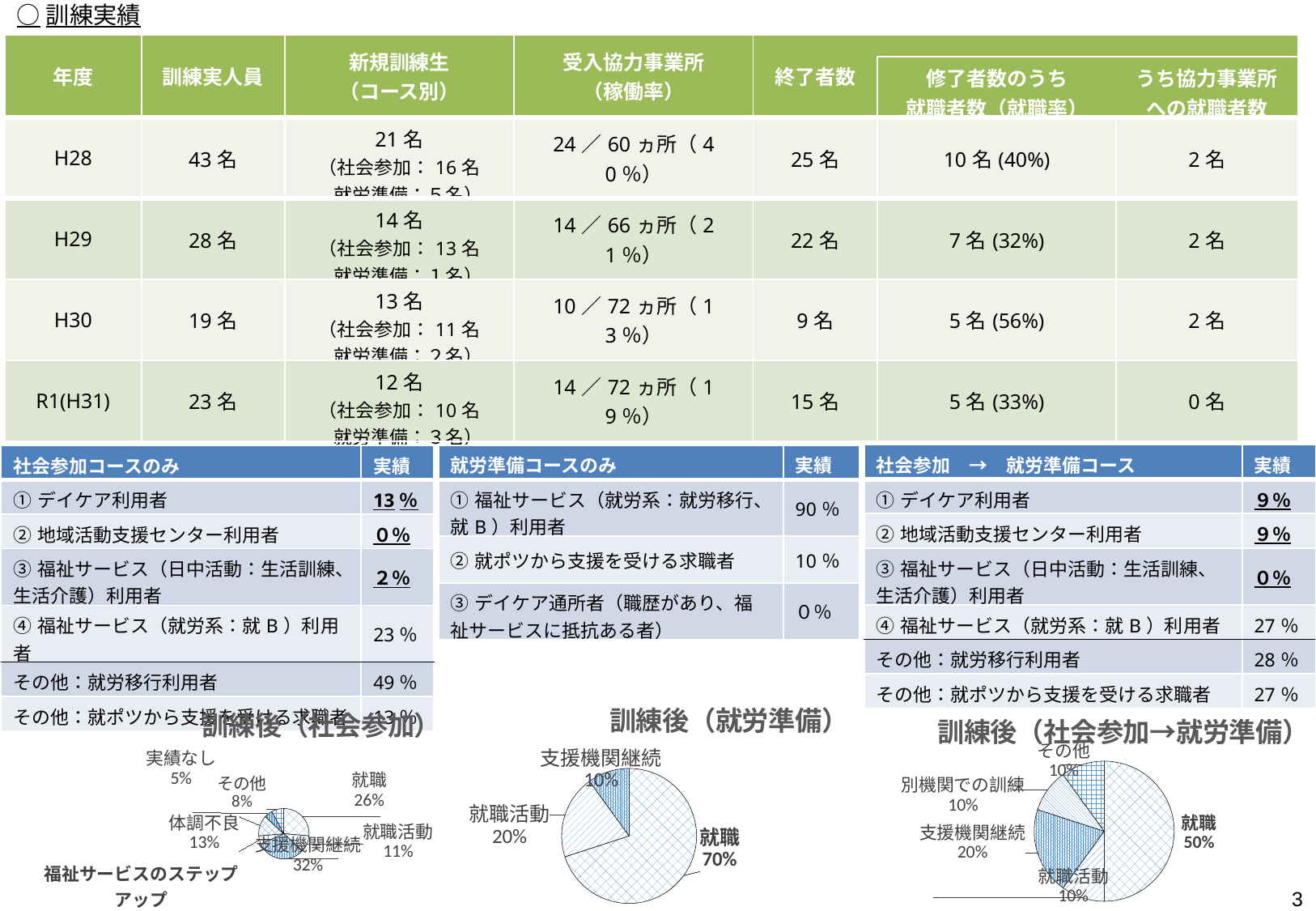
In the 訓練後（社会参加） pie chart, what share is 就職? 26% In the 訓練後（就労準備） pie chart, which category has the largest share? 就職 In the 訓練後（就労準備） pie chart, what share is 就職活動? 20% In the 訓練後（社会参加） pie chart, what share is 支援機関継続? 32% In the 訓練後（社会参加→就労準備） pie chart, what is the difference between 就職 and 支援機関継続? 30% What type of chart is the 訓練後（社会参加→就労準備） chart? pie chart In the 訓練後（社会参加→就労準備） pie chart, what share is 就職? 50% How many slices does the 訓練後（就労準備） pie chart have? 3 In the 訓練後（社会参加→就労準備） pie chart, what share is 支援機関継続? 20% In the 訓練後（就労準備） pie chart, which category has the smallest share? 支援機関継続 In the 訓練後（社会参加） pie chart, which is larger, 体調不良 or 実績なし? 体調不良 In the 訓練後（就労準備） pie chart, what share is 就職? 70%